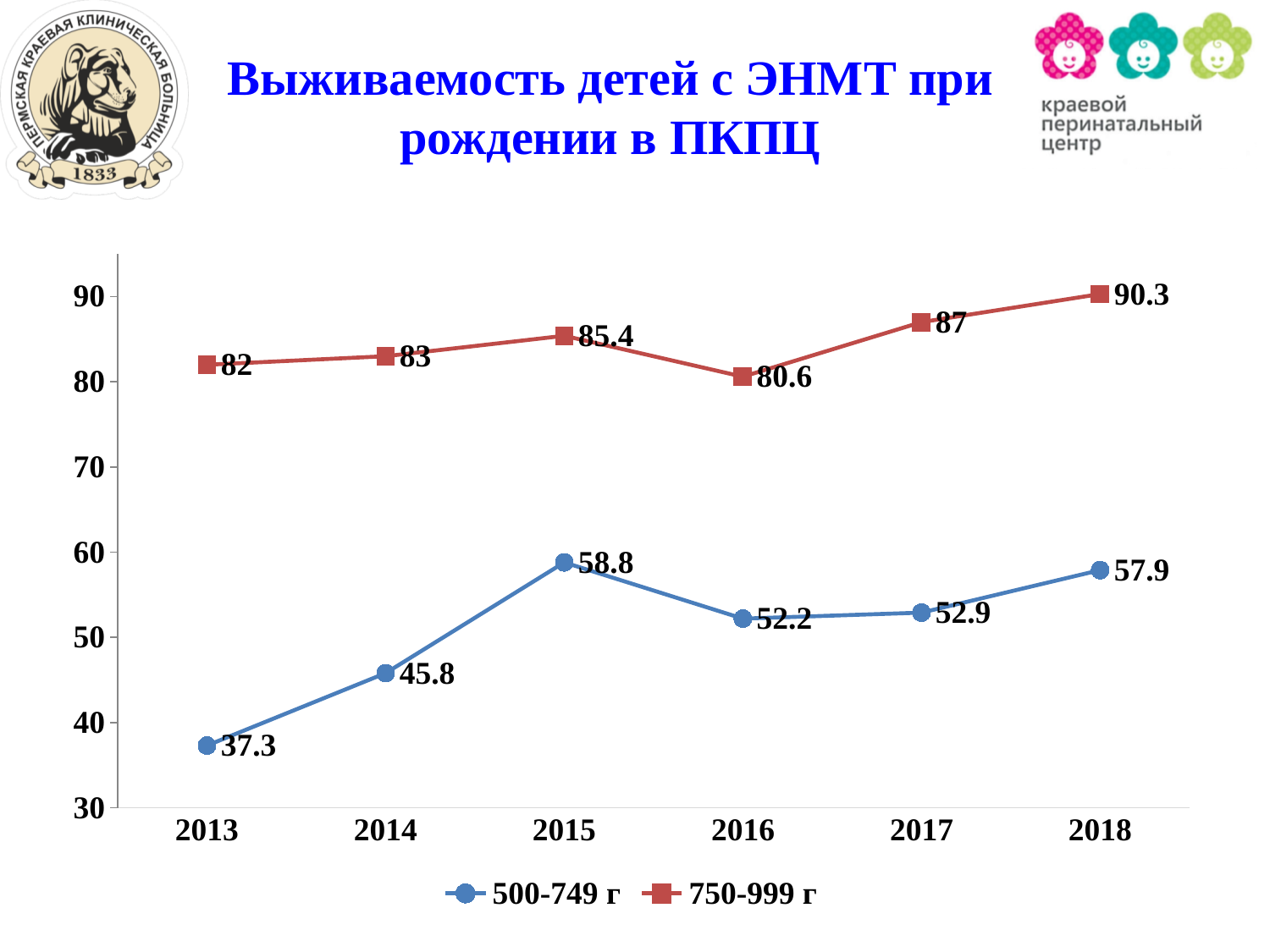
What is the value for the 500-749 г series in 2013? 37.3 What kind of chart is shown? line chart What is the value for the 750-999 г series in 2018? 90.3 In which year is the 500-749 г series highest? 2015 Is the value for 500-749 г in 2014 greater or less than 50? less Which is larger: the 500-749 г value in 2015 or in 2018? 2015 How many years are shown on the x axis? 6 In which year is the 750-999 г series lowest? 2016 Does the 750-999 г series rise or fall from 2016 to 2018? rise How many series does the legend list? 2 What is the value for the 750-999 г series in 2016? 80.6 What is the difference between the 750-999 г and 500-749 г values in 2018? 32.4